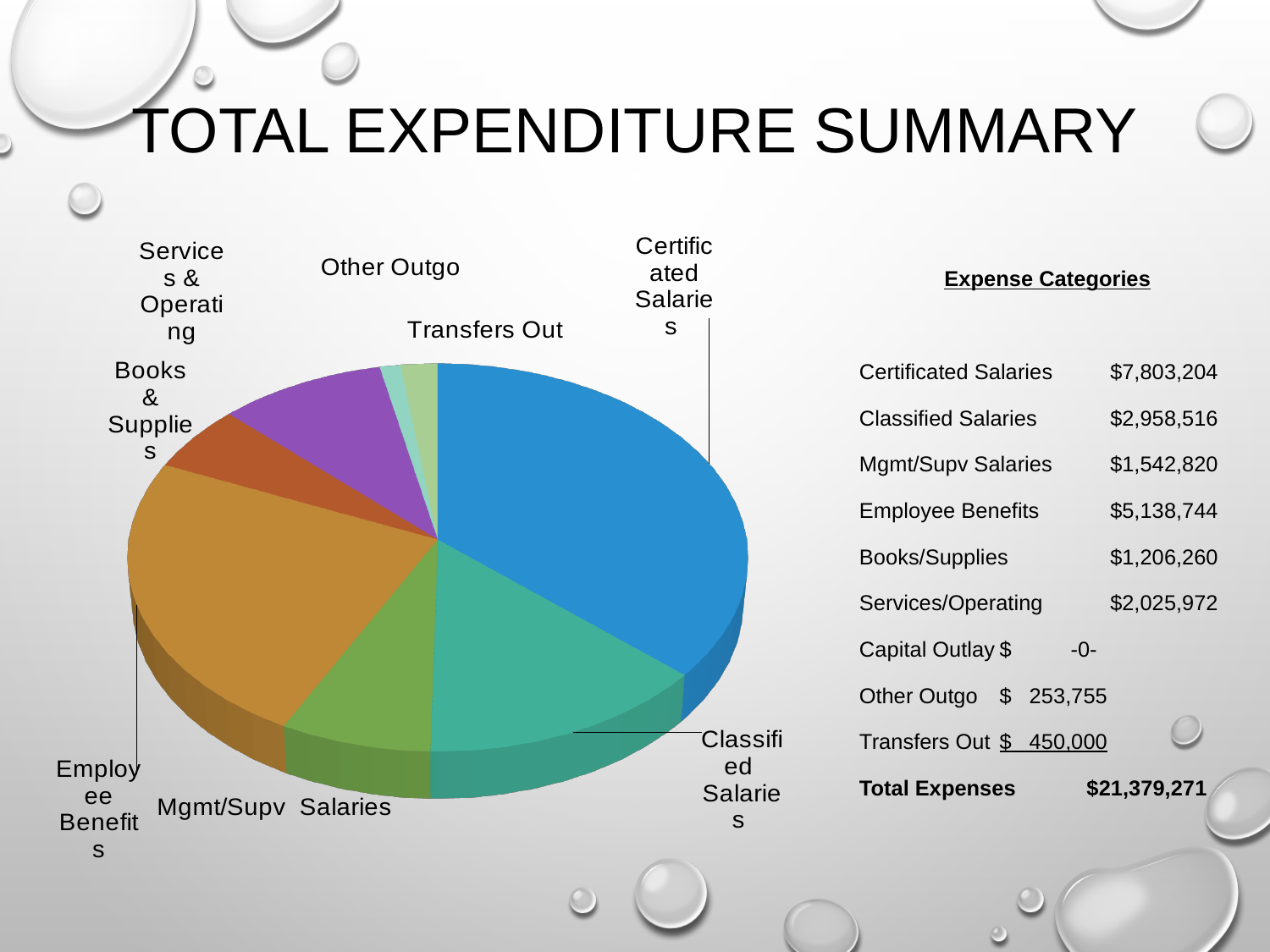
According to the Expense Categories list, what is the value for Certificated Salaries? $7,803,204 According to the Expense Categories list, what is the value for Employee Benefits? $5,138,744 What kind of chart is shown on the slide? Pie chart Which labeled slice of the pie chart is the smallest? Other Outgo What is the difference between Certificated Salaries and Classified Salaries according to the values on the slide? $4,844,688 How many labeled slices does the pie chart have? 8 Which expense category has the largest slice of the pie chart? Certificated Salaries What share of Total Expenses does Certificated Salaries represent, based on the values on the slide? 36.5% What is the title of the slide containing the pie chart? TOTAL EXPENDITURE SUMMARY Which slice is larger in the pie chart, Employee Benefits or Classified Salaries? Employee Benefits What is the Total Expenses figure shown on the slide? $21,379,271 Which slice is larger in the pie chart, Mgmt/Supv Salaries or Certificated Salaries? Certificated Salaries